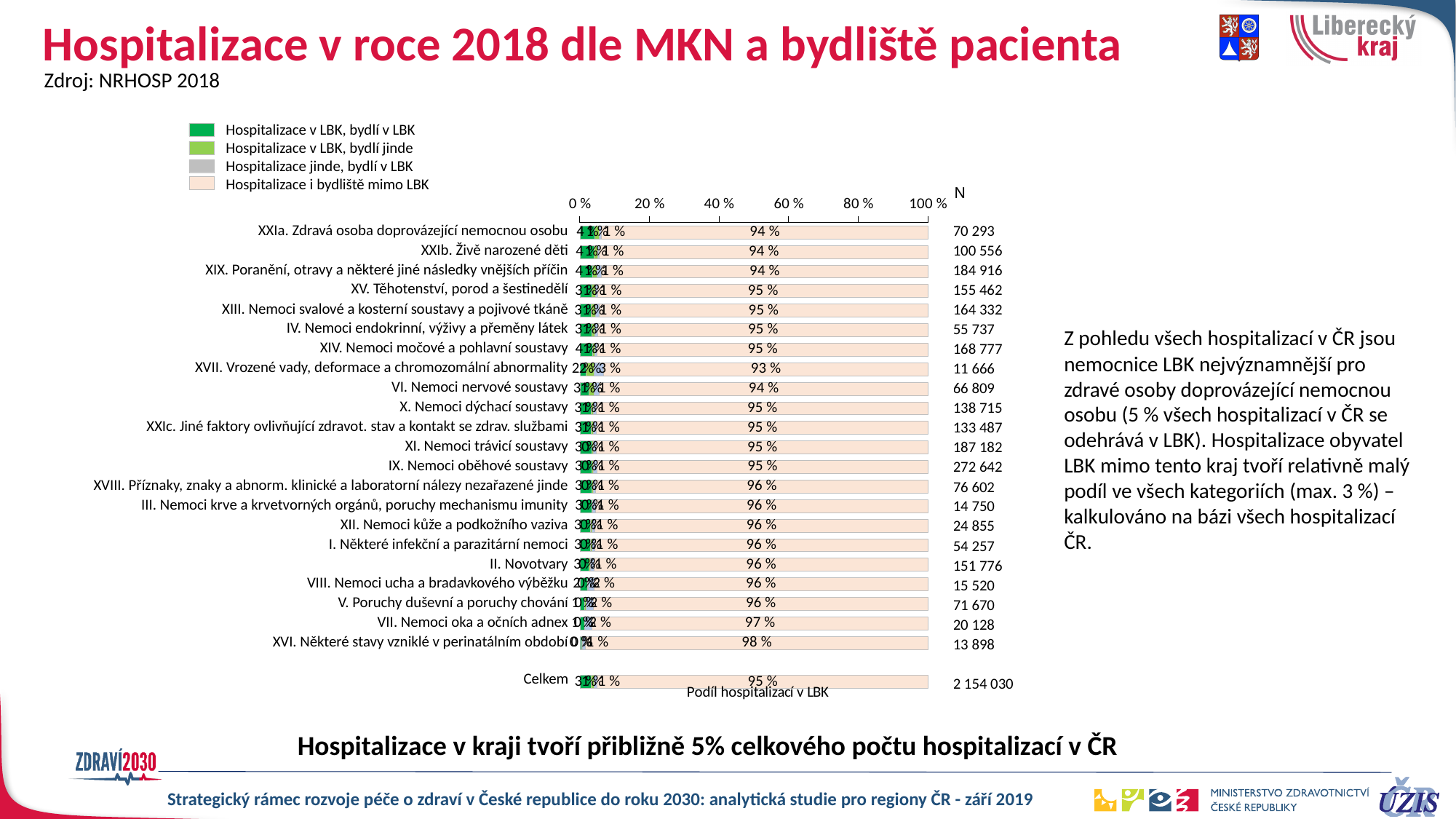
How many series does the chart legend list? 4 What is the value of 'Hospitalizace i bydliště mimo LBK' for 'XVI. Některé stavy vzniklé v perinatálním období'? 98 % What is the difference in the 'Hospitalizace i bydliště mimo LBK' share between 'XVI. Některé stavy vzniklé v perinatálním období' and 'XVII. Vrozené vady, deformace a chromozomální abnormality'? 5 percentage points Which category has the lowest share of 'Hospitalizace i bydliště mimo LBK'? XVII. Vrozené vady, deformace a chromozomální abnormality What is the N value shown for 'IX. Nemoci oběhové soustavy'? 272 642 Which has the larger N value: 'XXIb. Živě narozené děti' or 'XIX. Poranění, otravy a některé jiné následky vnějších příčin'? XIX. Poranění, otravy a některé jiné následky vnějších příčin How many bars (categories including Celkem) are plotted in the chart? 23 What kind of chart is shown on the slide? stacked bar chart What is the value of 'Hospitalizace i bydliště mimo LBK' for 'Celkem'? 95 % What is the value of 'Hospitalizace i bydliště mimo LBK' for 'XVII. Vrozené vady, deformace a chromozomální abnormality'? 93 % Which category has the highest share of 'Hospitalizace i bydliště mimo LBK'? XVI. Některé stavy vzniklé v perinatálním období What is the N value shown for 'Celkem'? 2 154 030